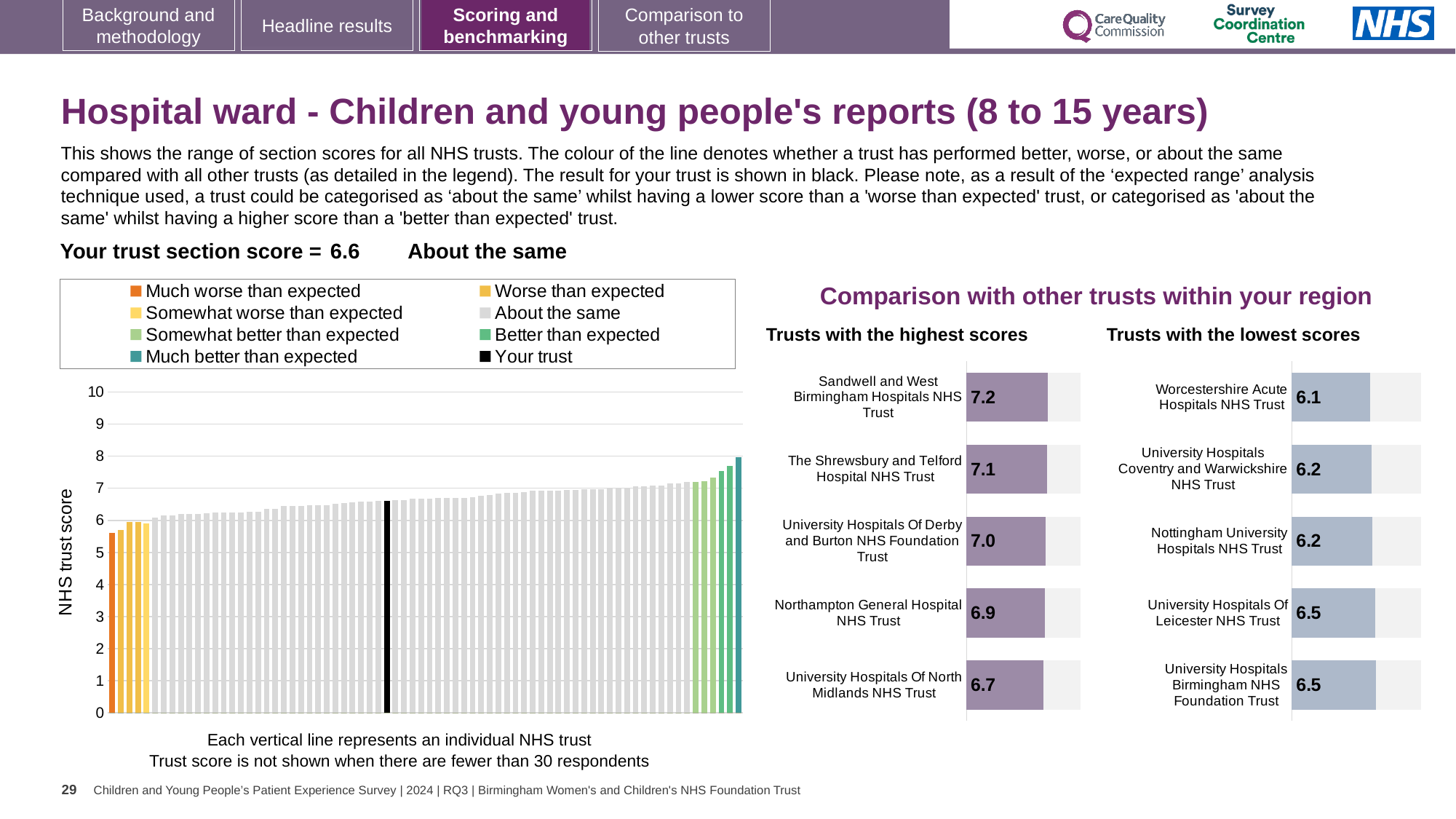
In the 'Trusts with the lowest scores' chart, which trust has the lowest score? Worcestershire Acute Hospitals NHS Trust In the large chart on the left, is the value for the black 'Your trust' bar greater or less than 6? greater What kind of chart is the large chart on the left with the 'NHS trust score' axis? Bar chart In the 'Trusts with the lowest scores' chart, what is the score for University Hospitals Of Leicester NHS Trust? 6.5 In the 'Trusts with the highest scores' chart, what is the score for University Hospitals Of North Midlands NHS Trust? 6.7 In the 'Trusts with the highest scores' chart, what is the difference between the scores of Sandwell and West Birmingham Hospitals NHS Trust and University Hospitals Of North Midlands NHS Trust? 0.5 In the 'Trusts with the highest scores' chart, how many trusts are listed? 5 In the 'Trusts with the highest scores' chart, which trust has the highest score? Sandwell and West Birmingham Hospitals NHS Trust Which has a higher score: Northampton General Hospital NHS Trust in the 'highest scores' chart or Nottingham University Hospitals NHS Trust in the 'lowest scores' chart? Northampton General Hospital NHS Trust In the 'Trusts with the highest scores' chart, what is the score for Sandwell and West Birmingham Hospitals NHS Trust? 7.2 In the 'Trusts with the lowest scores' chart, what is the score for Worcestershire Acute Hospitals NHS Trust? 6.1 In the 'Trusts with the lowest scores' chart, what is the difference between the scores of University Hospitals Birmingham NHS Foundation Trust and Worcestershire Acute Hospitals NHS Trust? 0.4